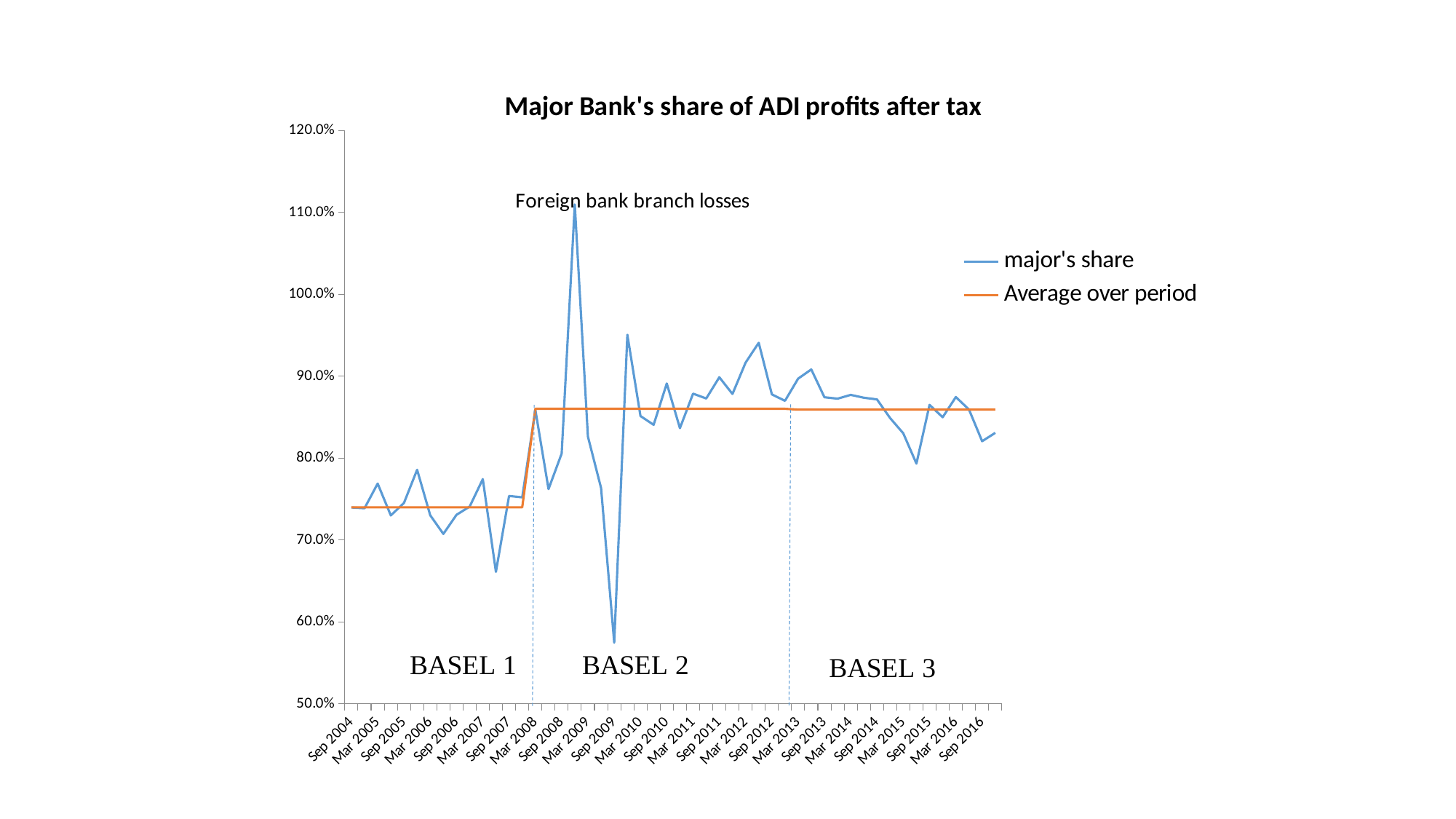
Is the Average over period value during the BASEL 3 period greater or less than 80.0%? greater What kind of chart is shown on the slide? line chart What is the title of the chart? Major Bank's share of ADI profits after tax What annotation text is placed near the peak of the major's share line? Foreign bank branch losses Does the Average over period line rise or fall when moving from the BASEL 1 period to the BASEL 2 period? rise Is the major's share value at Sep 2004 greater or less than 80.0%? less How many series does the legend list? 2 Is the major's share value at Mar 2009 greater or less than 100.0%? less At which date does the major's share series reach its lowest value? Sep 2009 Which is larger, the major's share at Mar 2009 or at Sep 2009? Mar 2009